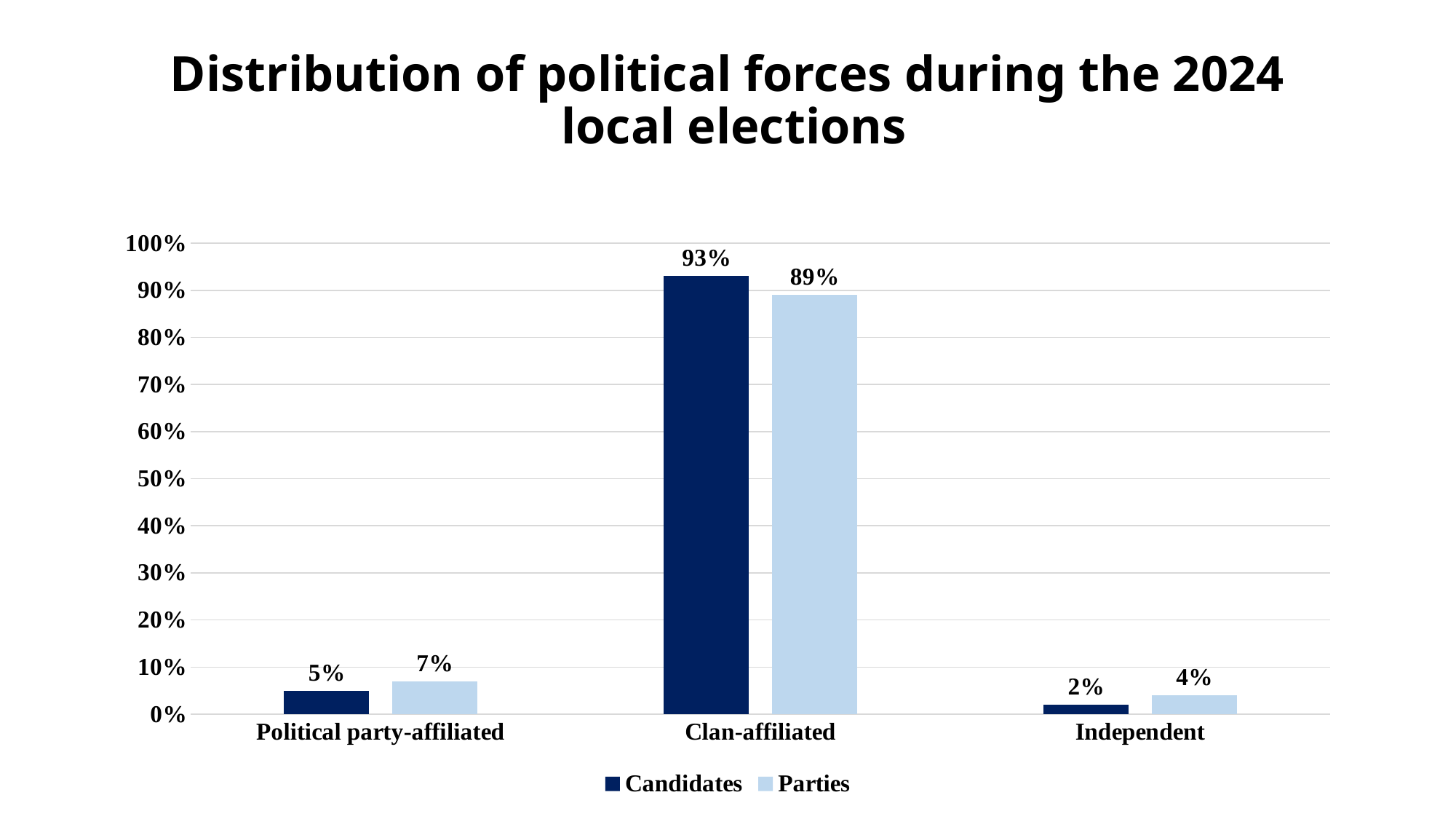
What is the Parties value for Independent? 4% What kind of chart is shown on the slide? Bar chart What is the Candidates value for Clan-affiliated? 93% Which category has the lowest Parties value? Independent Which category has the highest Candidates value? Clan-affiliated How many series does the legend list? 2 Which is larger for Political party-affiliated, the Candidates value or the Parties value? Parties What is the Parties value for Political party-affiliated? 7% What is the title of the chart? Distribution of political forces during the 2024 local elections What is the difference between the Candidates and Parties values for Clan-affiliated? 4% What is the Candidates value for Independent? 2% How many categories are shown on the x axis? 3